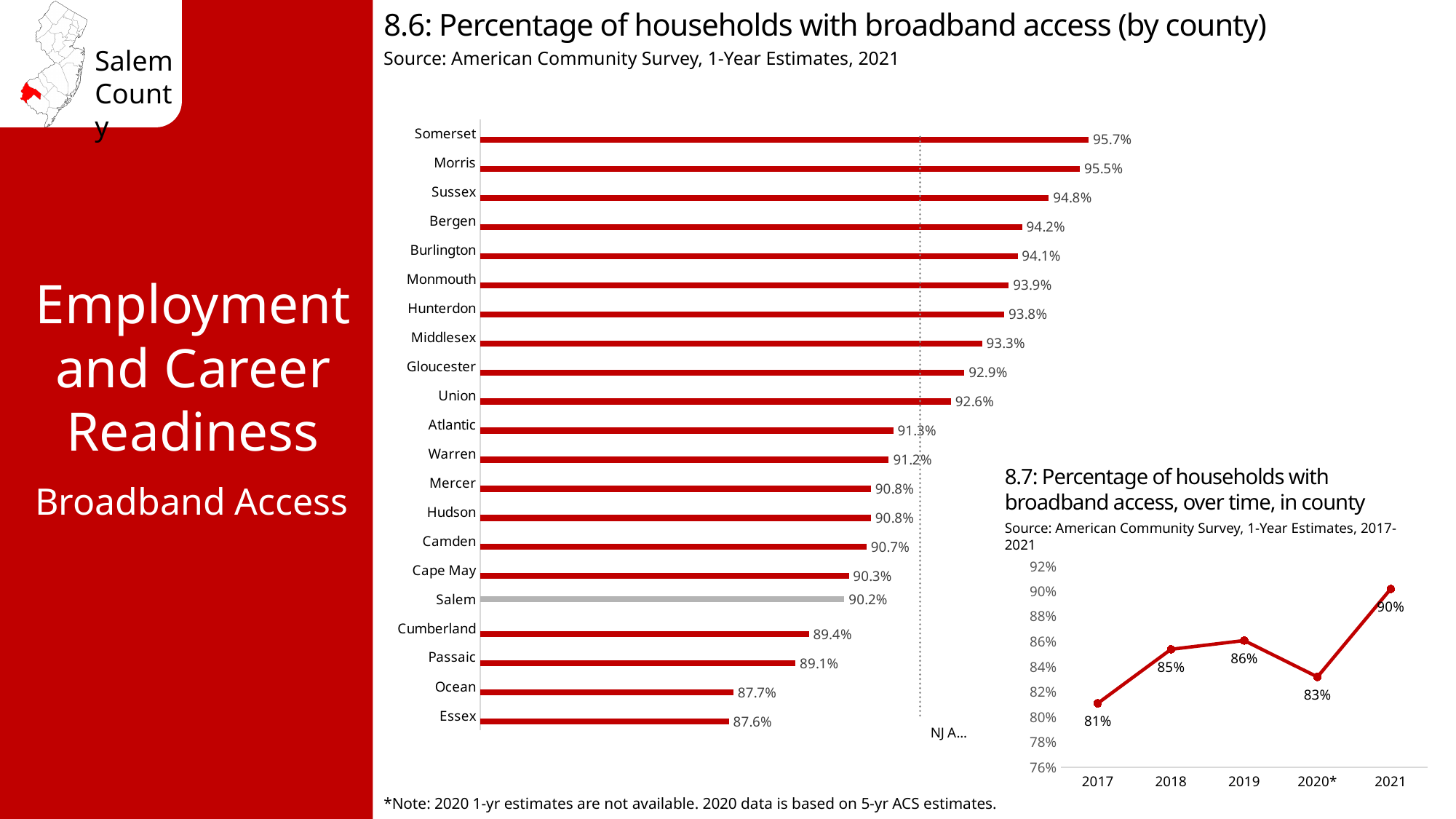
In chart 8.6, how many counties are shown? 21 In chart 8.7, what is the difference between the 2021 value and the 2017 value? 9% In chart 8.6, which is larger, the value for Cumberland or the value for Passaic? Cumberland In chart 8.6, what is the value for Gloucester? 92.9% In chart 8.7 (Percentage of households with broadband access over time in county), what is the value for 2019? 86% In chart 8.6 (Percentage of households with broadband access by county), what is the value for Salem? 90.2% In chart 8.6, which county has the highest percentage of households with broadband access? Somerset In chart 8.6, what is the difference between Somerset and Essex? 8.1% In chart 8.7, which year has the lowest percentage? 2017 What kind of chart is chart 8.6? Bar chart In chart 8.7, how many data points are plotted? 5 In chart 8.6, which county has the lowest percentage of households with broadband access? Essex